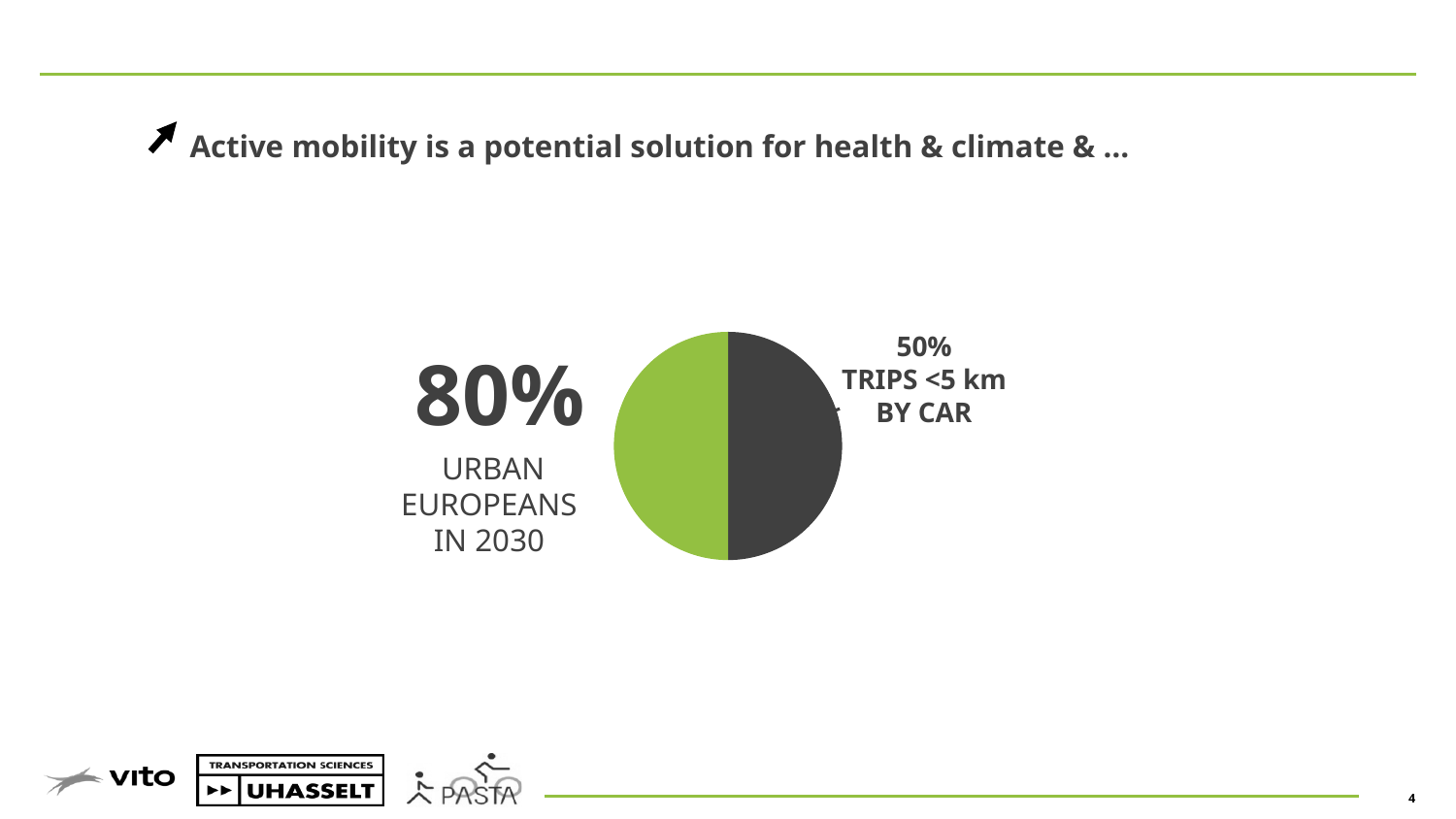
Are the two slices of the pie chart equal in size? Yes How many slices does the pie chart have? 2 What share of the pie does the dark grey slice labelled 'TRIPS <5 km BY CAR' represent? 50% What colour is the slice labelled 'TRIPS <5 km BY CAR'? dark grey What share of the pie does the green slice represent? 50% What kind of chart is shown on the slide? pie chart Is the share of trips <5 km by car greater or less than 25%? greater What does the dark grey slice of the pie chart represent? Trips <5 km by car